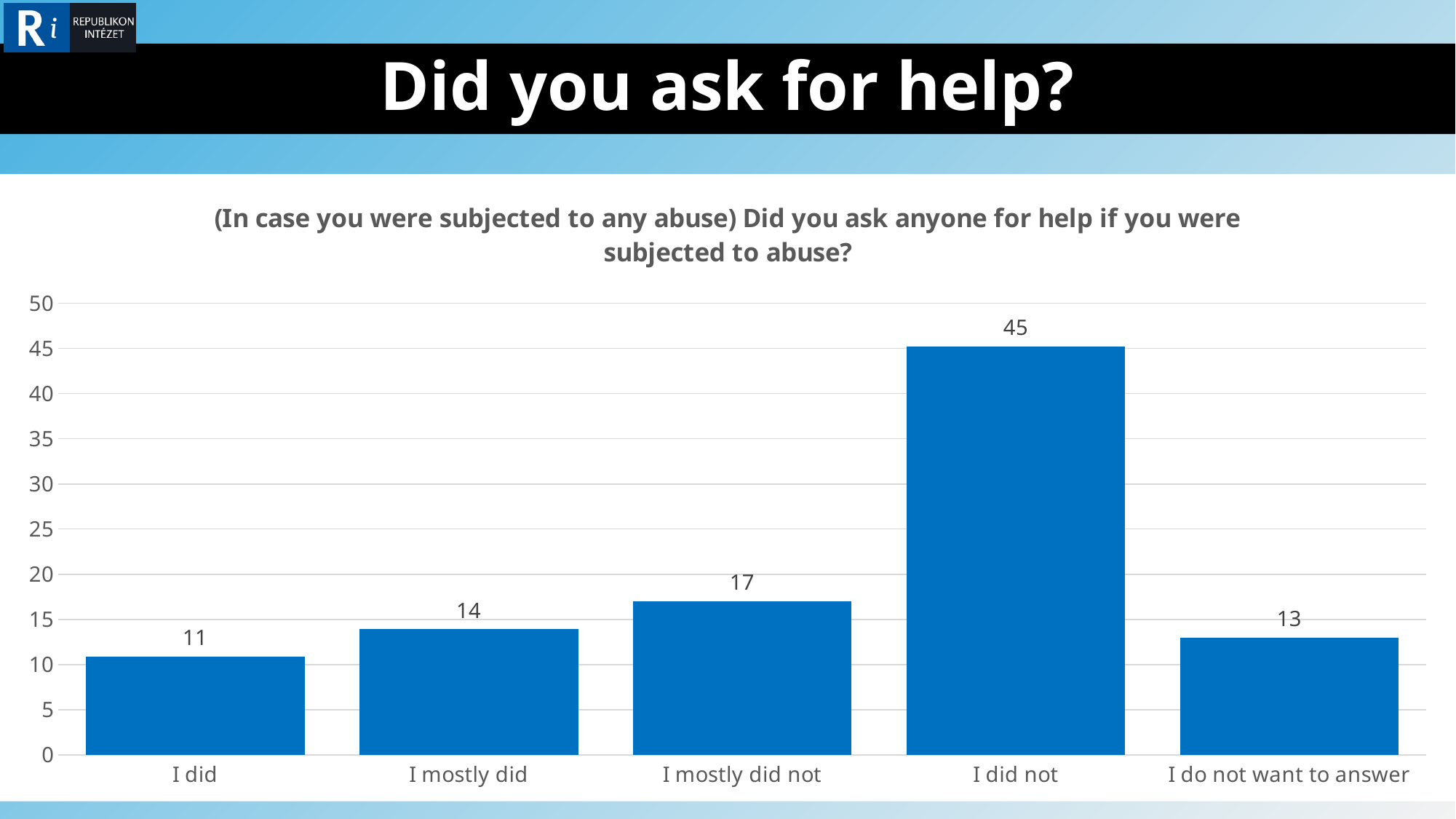
Which is larger, the value for "I mostly did not" or the value for "I do not want to answer"? I mostly did not Which category has the highest value? I did not What kind of chart is shown on the slide? bar chart How many categories are shown on the x axis? 5 What is the title shown in the black banner at the top of the slide? Did you ask for help? Is the value for "I did not" greater or less than 40? greater Which category has the lowest value? I did What is the difference between the values for "I mostly did" and "I did"? 3 What is the value for "I did not"? 45 What is the difference between the values for "I did not" and "I mostly did not"? 28 What is the value for "I mostly did"? 14 What is the value for "I do not want to answer"? 13